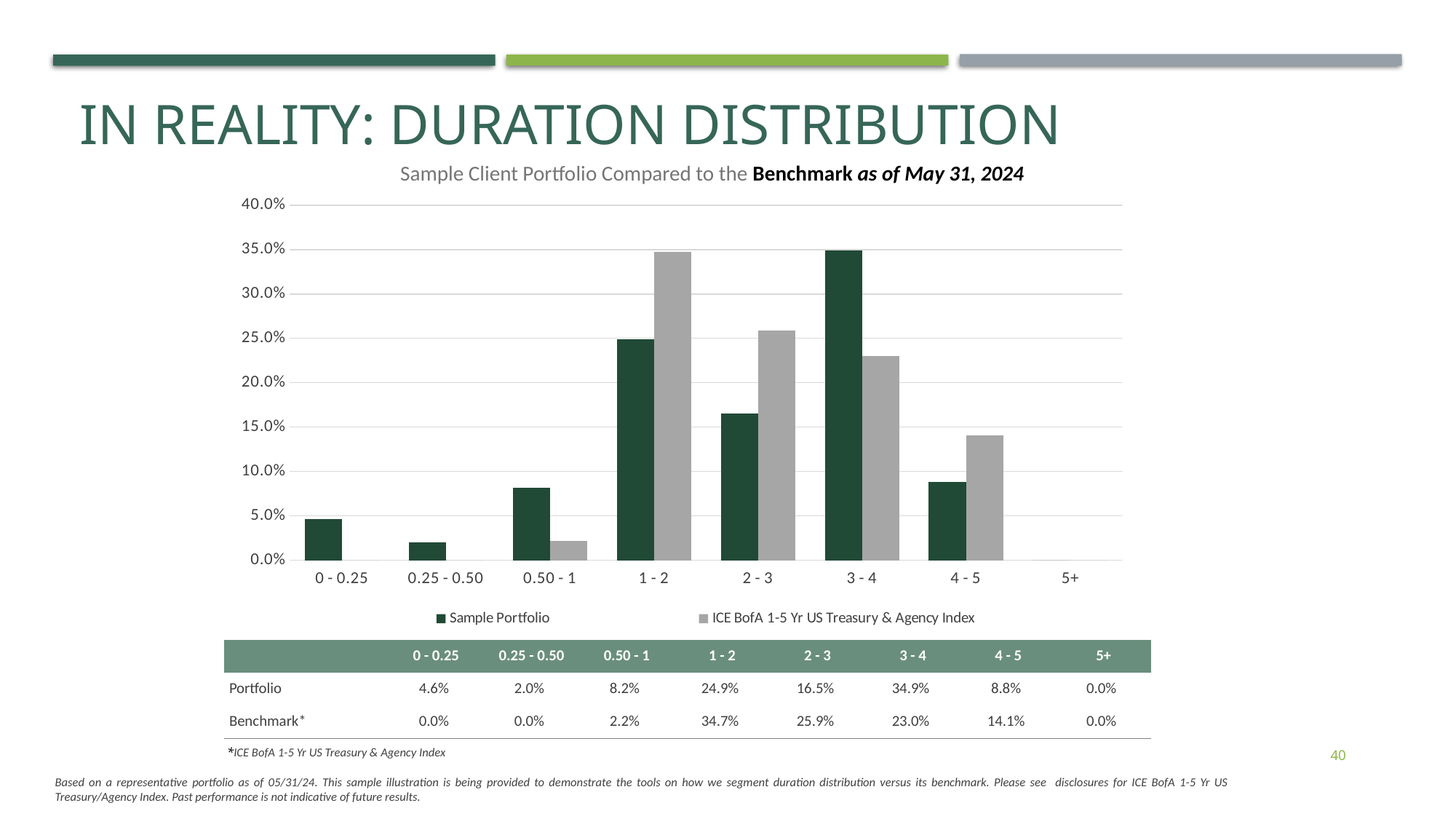
Is the Sample Portfolio value for the 1 - 2 bucket greater or less than 20.0%? greater What is the difference between the Benchmark and Sample Portfolio values in the 2 - 3 bucket? 9.4% In the 4 - 5 bucket, which is larger: the Sample Portfolio or the Benchmark? Benchmark What is the Sample Portfolio value for the 3 - 4 duration bucket? 34.9% What is the Sample Portfolio value for the 0 - 0.25 duration bucket? 4.6% What is the Benchmark value for the 1 - 2 duration bucket? 34.7% How many series does the legend list? 2 Which duration bucket has the highest Sample Portfolio value? 3 - 4 How many duration categories are shown on the x axis? 8 What is the title of the chart? Sample Client Portfolio Compared to the Benchmark as of May 31, 2024 What kind of chart is shown on the slide? bar chart Which duration bucket has the highest Benchmark value? 1 - 2